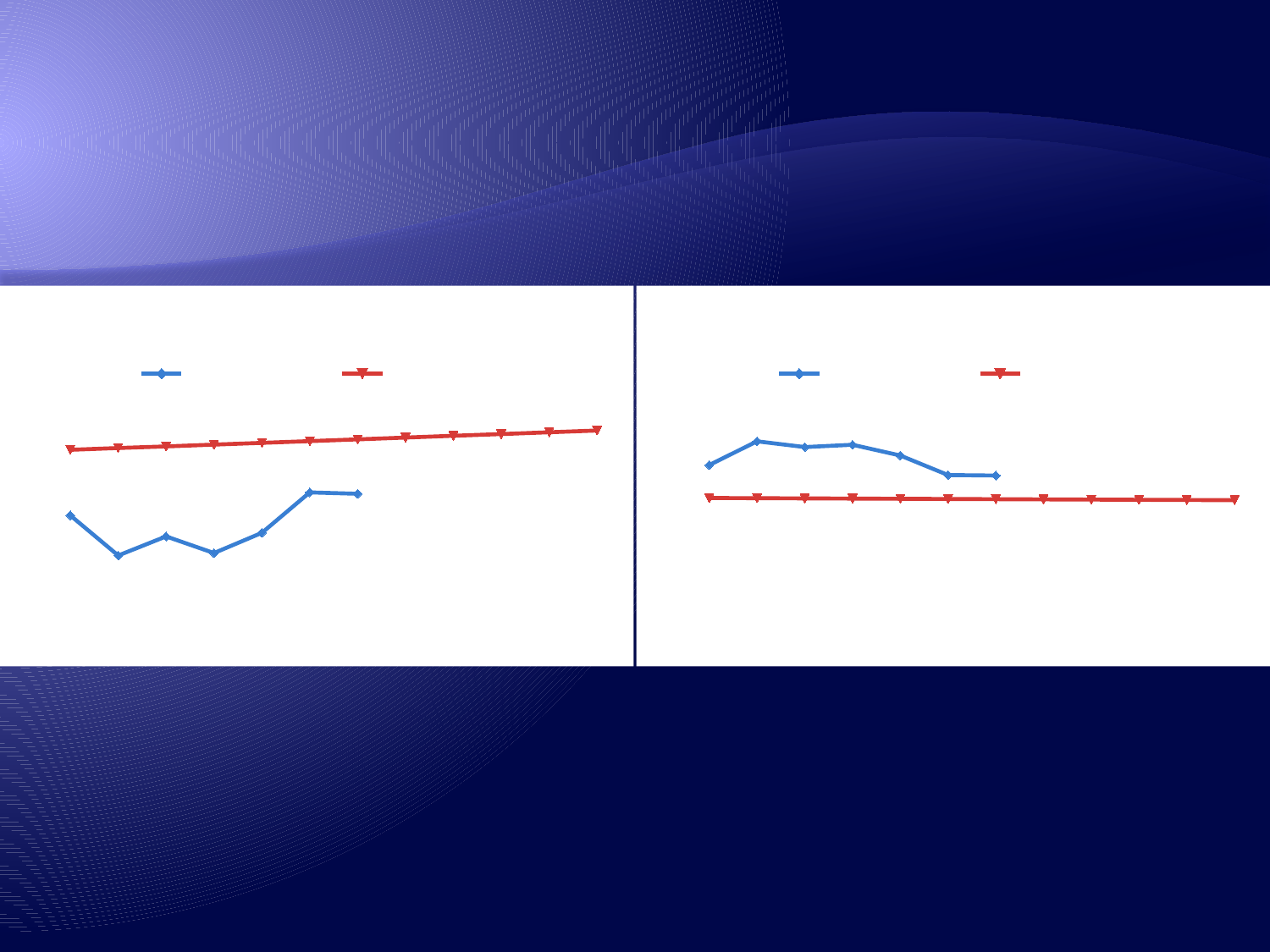
In the left chart, how many data points does the blue series have? 7 In the right chart, how many data points does the red series have? 12 What kind of chart is the chart on the left side of the slide? line chart In the left chart, does the red series rise or fall from left to right? rise How many series does the legend of the left chart list? 2 In the left chart, which series is plotted higher throughout, the blue or the red? red In the right chart, how many data points does the blue series have? 7 In the right chart, which series is plotted higher throughout, the blue or the red? blue How many series does the legend of the right chart list? 2 What colours are the two series lines in the right chart? blue and red What kind of chart is the chart on the right side of the slide? line chart